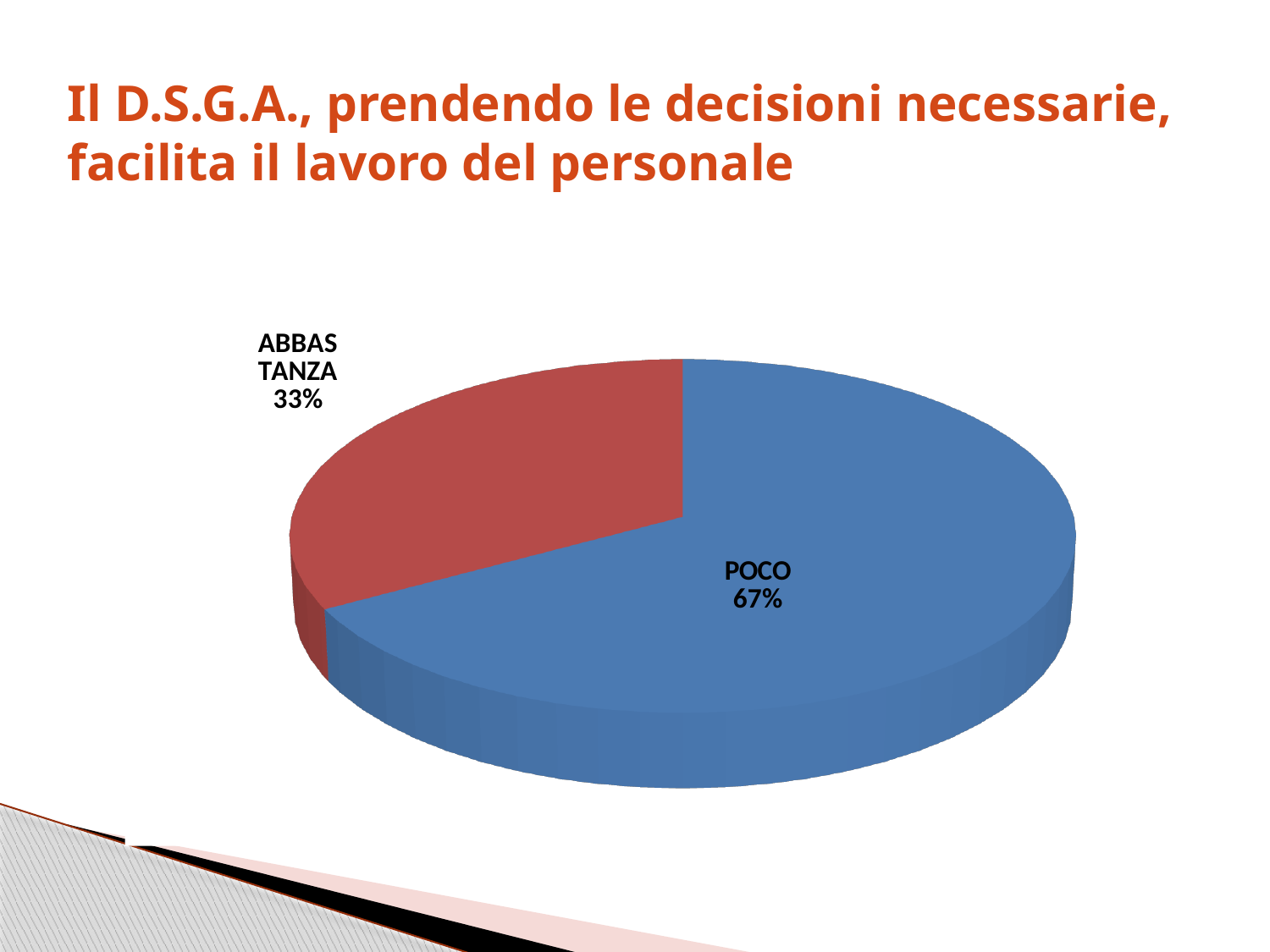
Which slice of the pie is the largest? POCO What kind of chart is shown on the slide? pie chart What share of the pie does the ABBASTANZA slice represent? 33% How many slices does the pie chart have? 2 Which slice of the pie is the smallest? ABBASTANZA What percentage is shown for POCO? 67% What is the difference in percentage points between POCO and ABBASTANZA? 34 What colour is the ABBASTANZA slice? red What percentage is shown for ABBASTANZA? 33% What colour is the POCO slice? blue Which is larger, the share for POCO or the share for ABBASTANZA? POCO